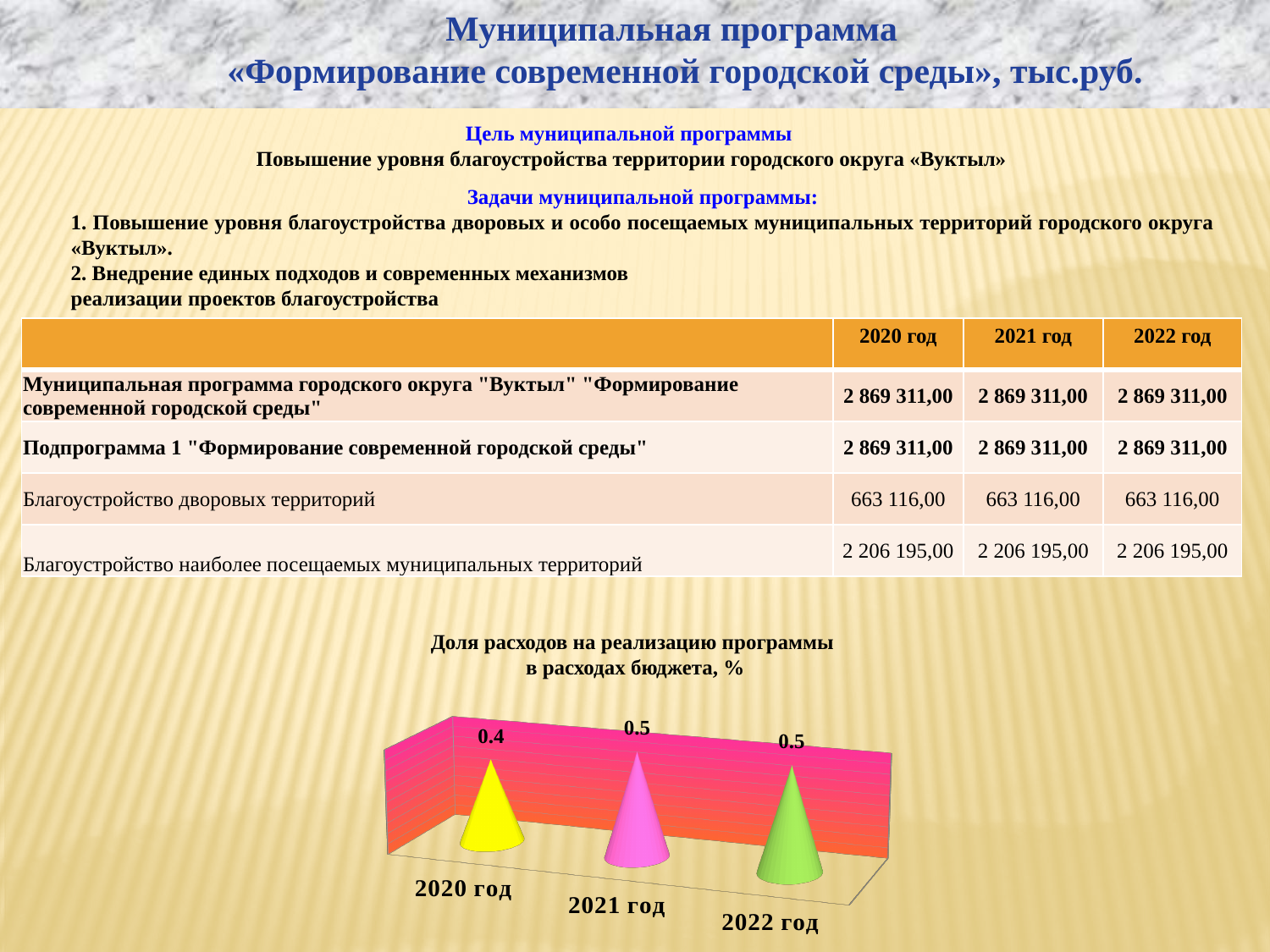
Do the values rise or fall from 2020 год to 2021 год? Rise What is the title of the chart? Доля расходов на реализацию программы в расходах бюджета, % What is the value shown for 2021 год in the chart? 0.5 What kind of chart is shown on the slide? Bar chart (3D cone bars) Which year has the lowest value in the chart? 2020 год What is the difference between the values for 2021 год and 2020 год? 0.1 Which is larger, the value for 2020 год or the value for 2021 год? 2021 год What is the value shown for 2020 год in the chart? 0.4 What is the value shown for 2022 год in the chart? 0.5 What colour is the cone for 2020 год? Yellow How many categories (years) are plotted in the chart? 3